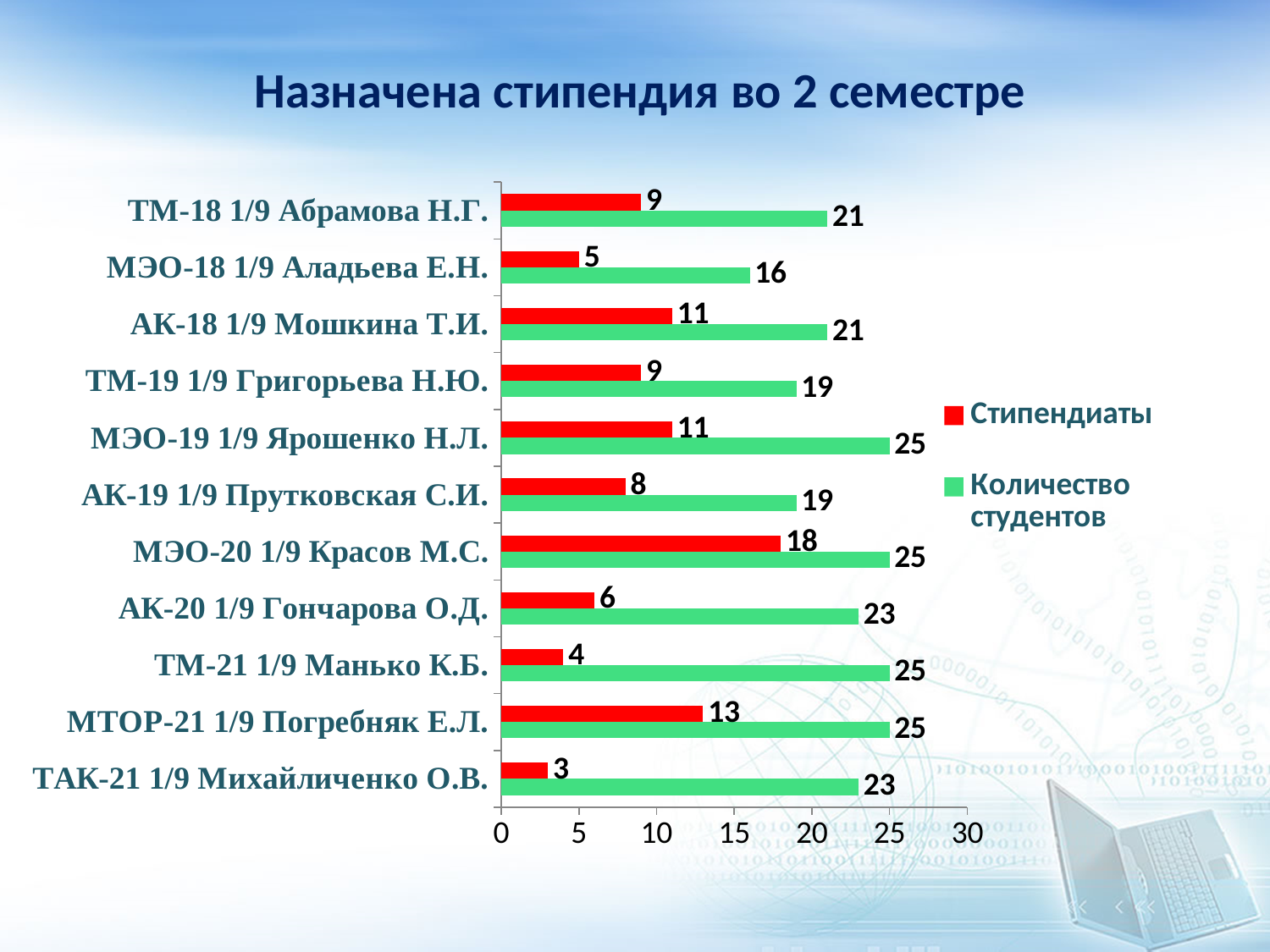
Which is larger: Стипендиаты for АК-18 1/9 Мошкина Т.И. or Стипендиаты for АК-20 1/9 Гончарова О.Д.? АК-18 1/9 Мошкина Т.И. What is the value of Стипендиаты for МТОР-21 1/9 Погребняк Е.Л.? 13 How many groups (categories) are shown on the chart? 11 What is the difference between Количество студентов and Стипендиаты for ТМ-21 1/9 Манько К.Б.? 21 What type of chart is shown on the slide? bar chart Which group has the highest value of Стипендиаты? МЭО-20 1/9 Красов М.С. What is the value of Стипендиаты for МЭО-20 1/9 Красов М.С.? 18 What is the value of Количество студентов for МЭО-18 1/9 Аладьева Е.Н.? 16 Which group has the lowest value of Стипендиаты? ТАК-21 1/9 Михайличенко О.В. Which group has the lowest value of Количество студентов? МЭО-18 1/9 Аладьева Е.Н. How many series does the legend list? 2 What is the title of the chart on the slide? Назначена стипендия во 2 семестре